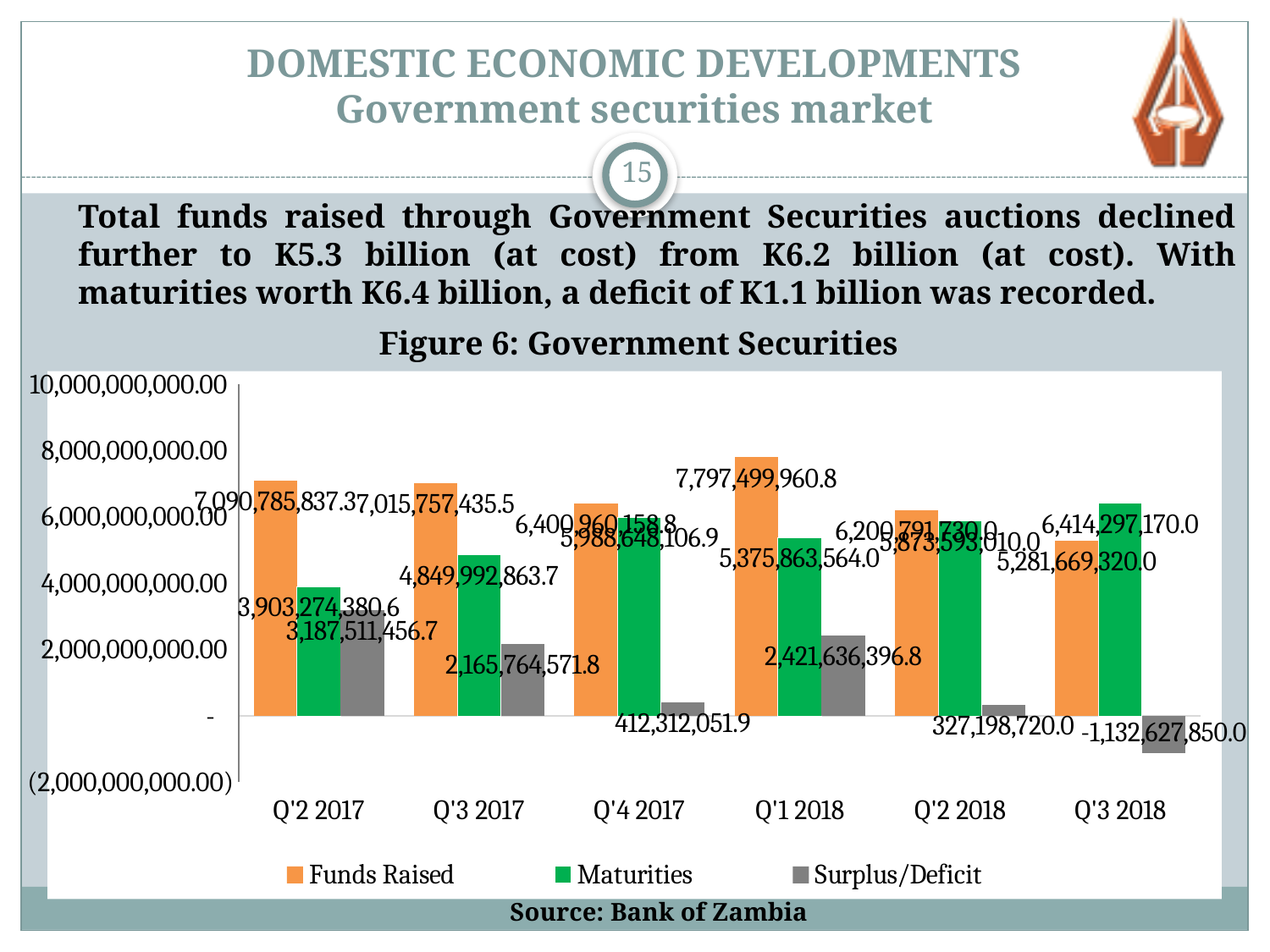
In which quarter is Funds Raised highest in Figure 6? Q'1 2018 Is the Funds Raised value for Q'2 2017 in Figure 6 greater or less than 6,000,000,000.00? greater In which quarter is Surplus/Deficit lowest in Figure 6? Q'3 2018 What is the Surplus/Deficit value for Q'3 2018 in Figure 6? -1,132,627,850.0 What kind of chart is Figure 6: Government Securities? Bar chart What is the Funds Raised value for Q'1 2018 in Figure 6? 7,797,499,960.8 Which colour represents Maturities in the legend of Figure 6? Green How many quarters are shown on the x axis of Figure 6? 6 How many series does the legend of Figure 6 list? 3 What is the Maturities value for Q'3 2017 in Figure 6? 4,849,992,863.7 What is the Surplus/Deficit value for Q'4 2017 in Figure 6? 412,312,051.9 In Q'3 2018, which is larger in Figure 6: Funds Raised or Maturities? Maturities